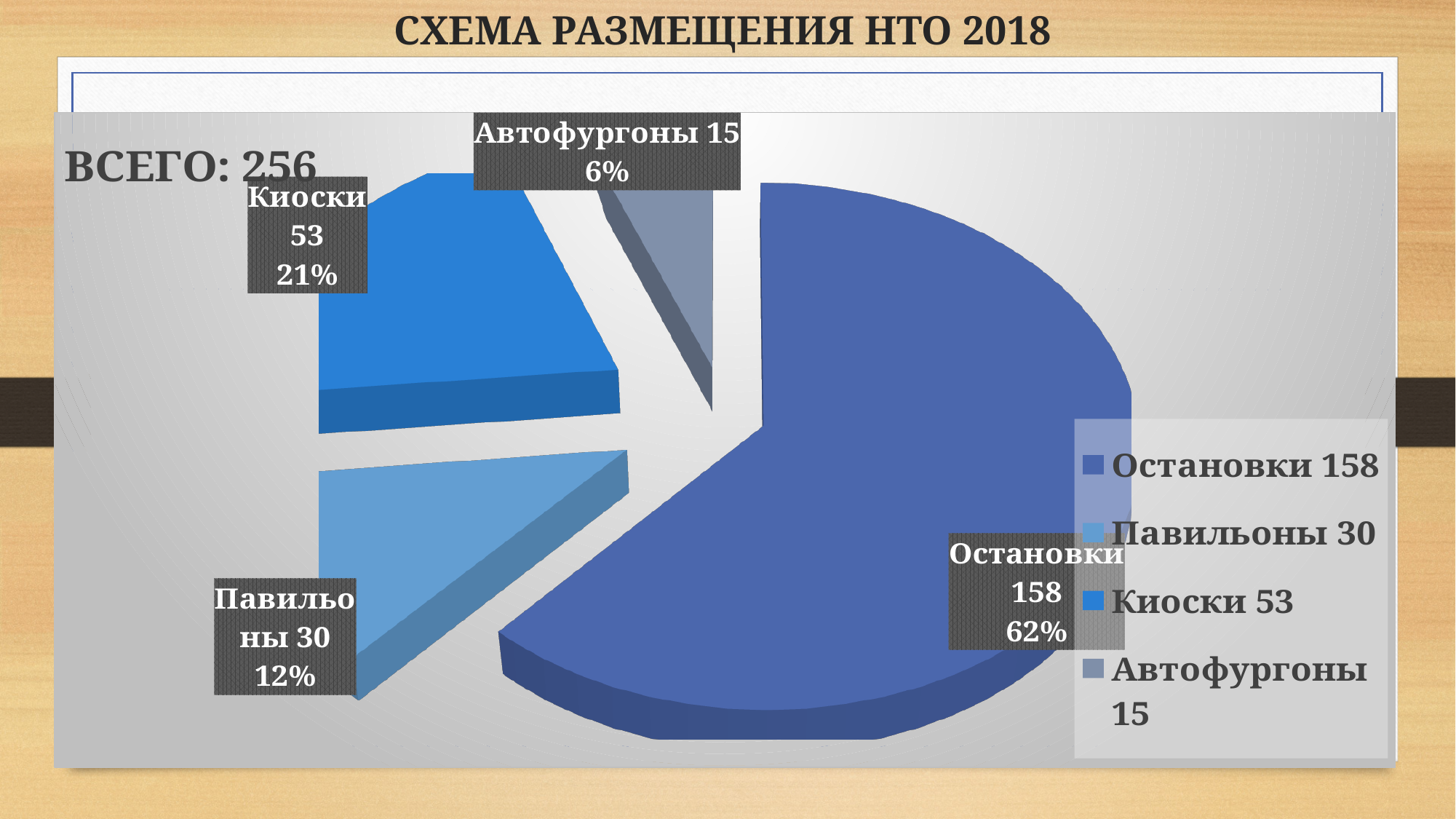
What is the value for Остановки? 158 How many slices does the pie chart have? 4 What is the value for Павильоны? 30 What is the value for Автофургоны? 15 What share of the pie does Киоски represent? 21% What total (ВСЕГО) is shown on the slide? 256 What is the value for Киоски? 53 Which category has the smallest slice of the pie? Автофургоны What share of the pie does Павильоны represent? 12% What kind of chart is shown on the slide? pie chart Which category has the largest slice of the pie? Остановки What is the difference between the values for Остановки and Киоски? 105